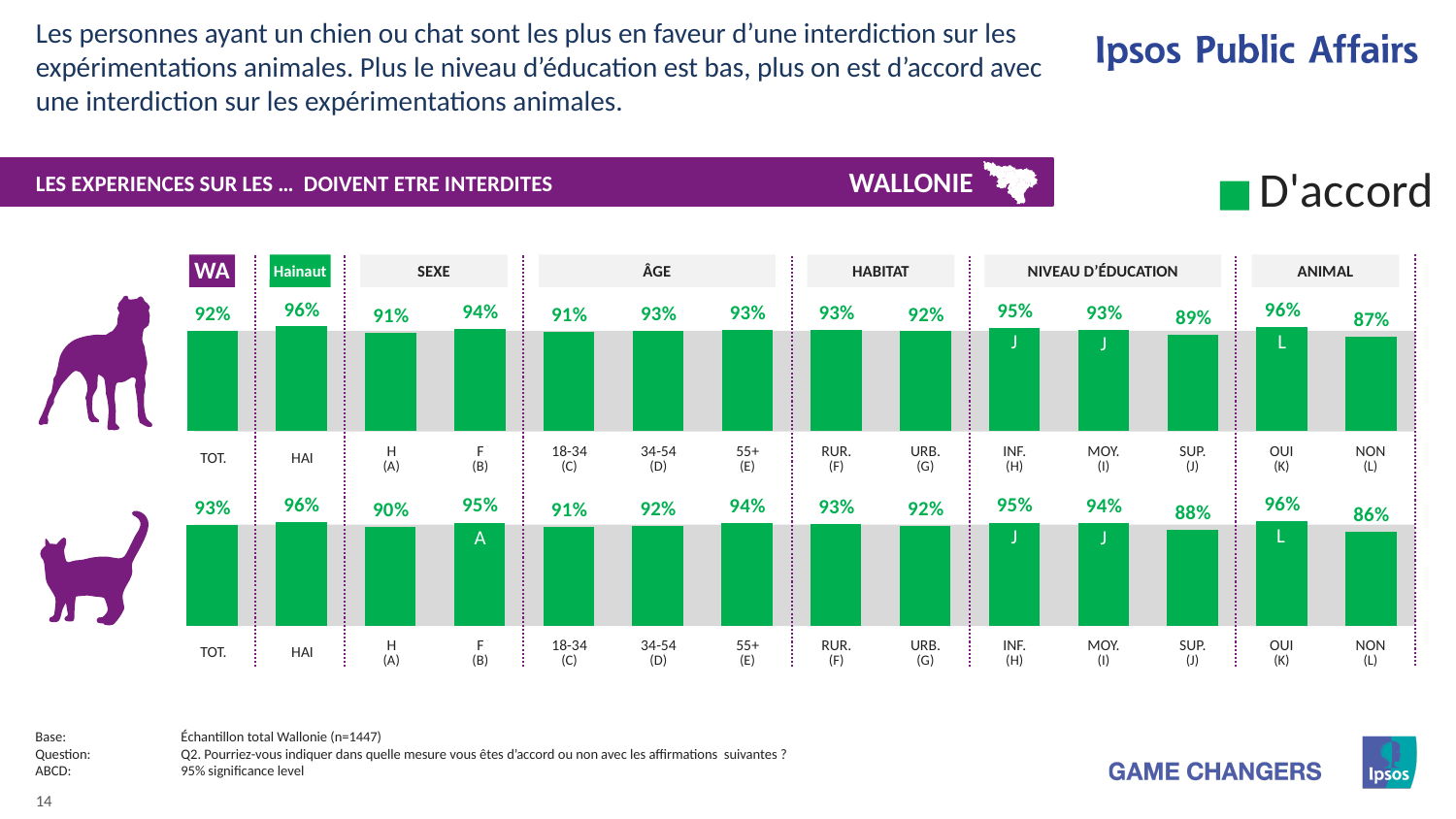
In the top row of bars (dog), what is the value for SUP. (J) under NIVEAU D'ÉDUCATION? 89% What kind of chart is used on this slide? bar chart In the top row of bars (dog), do the values rise or fall across the NIVEAU D'ÉDUCATION categories from INF. to SUP.? fall In the bottom row of bars (cat), what is the value for F (B) under SEXE? 95% In the bottom row of bars (cat), which category under NIVEAU D'ÉDUCATION has the highest value? INF. (H) In the top row of bars (dog), which category has the lowest value? NON (L) In the bottom row of bars (cat), what is the value for NON (L) under ANIMAL? 86% In the bottom row of bars (cat), which is larger, the value for 18-34 (C) or 55+ (E)? 55+ (E) In the bottom row of bars (cat), what is the difference between H (A) and F (B) under SEXE? 5 percentage points In the top row of bars (dog), what is the value for TOT.? 92% In the top row of bars (dog), what is the difference between OUI (K) and NON (L) under ANIMAL? 9 percentage points How many bars are shown in the top row (dog)? 14